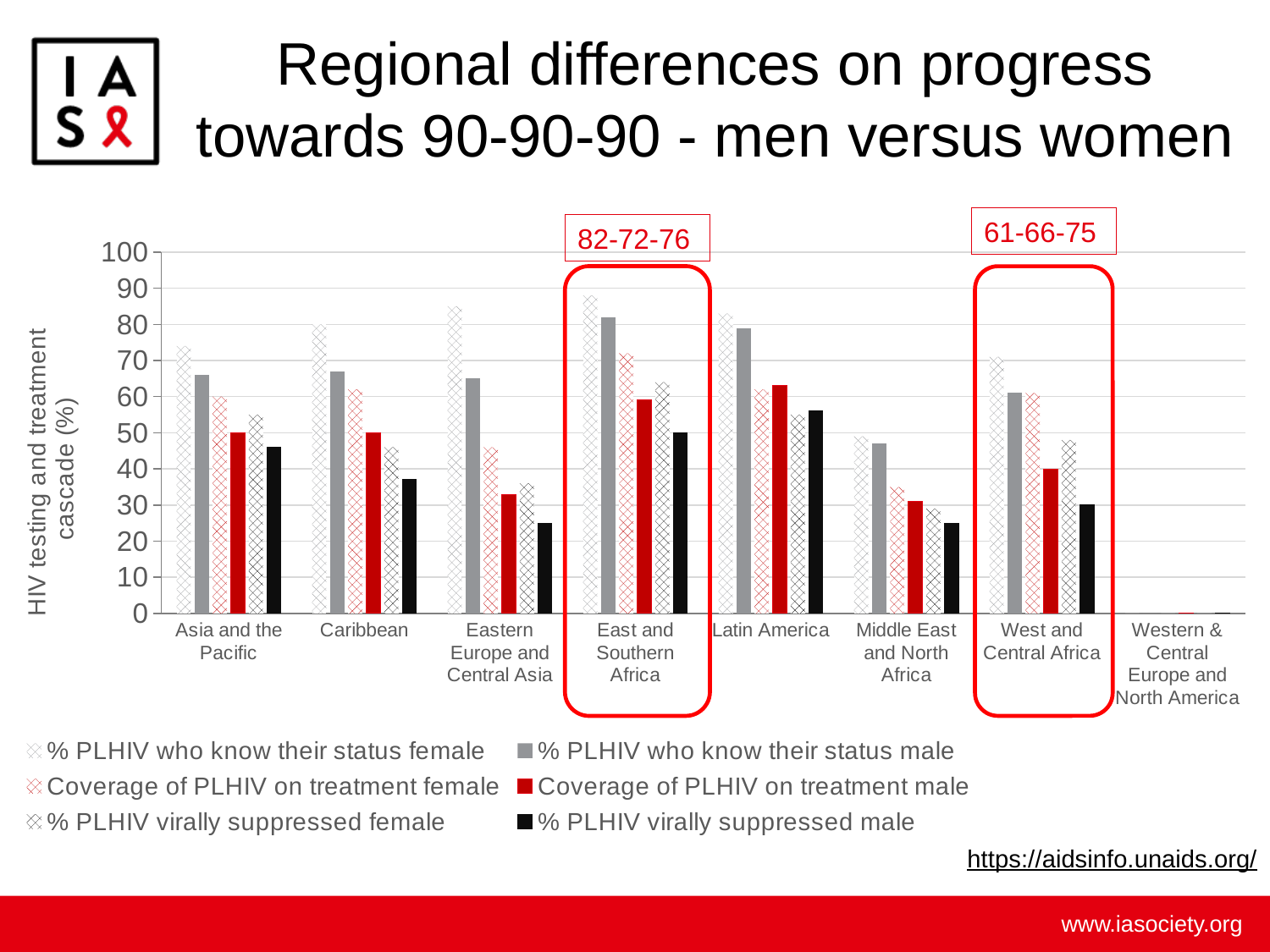
In Asia and the Pacific, which is larger: Coverage of PLHIV on treatment female or Coverage of PLHIV on treatment male? Coverage of PLHIV on treatment female Is the value for Coverage of PLHIV on treatment male in Eastern Europe and Central Asia greater or less than 40? less How many regions are shown along the x axis of the chart? 8 What is the title of the chart's y axis? HIV testing and treatment cascade (%) Is the value for % PLHIV virally suppressed male in West and Central Africa greater or less than 40? less Is the value for % PLHIV who know their status male in the Caribbean greater or less than 60? greater Which region has the highest value for % PLHIV virally suppressed male? Latin America Which region has the highest value for Coverage of PLHIV on treatment female? East and Southern Africa What annotation is shown in the red box above the East and Southern Africa bars? 82-72-76 How many series does the chart's legend list? 6 What kind of chart is shown on the slide? Bar chart